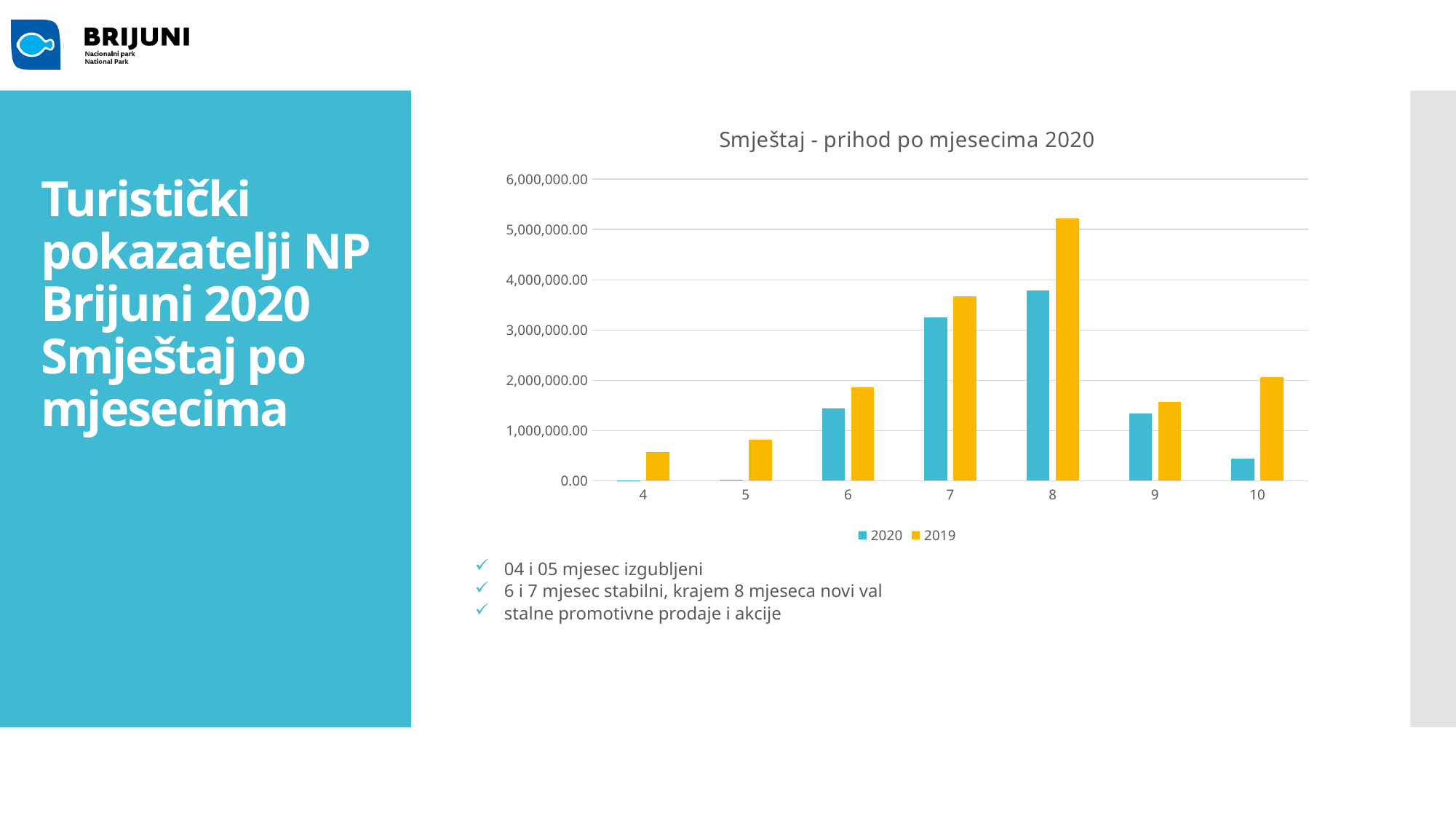
In which month is the 2020 value highest? 8 Is the 2019 value for month 8 greater or less than 5,000,000.00? greater What kind of chart is shown on the slide? bar chart In which month is the 2019 value highest? 8 How many series does the legend list? 2 In month 10, which series has the larger value, 2020 or 2019? 2019 How many months (categories) are shown on the x axis? 7 Is the 2020 value for month 10 greater or less than 1,000,000.00? less What is the title of the chart? Smještaj - prihod po mjesecima 2020 Is the 2020 value for month 7 greater or less than 3,000,000.00? greater Which colour represents the 2019 series in the chart? yellow In which month is the 2019 value lowest? 4